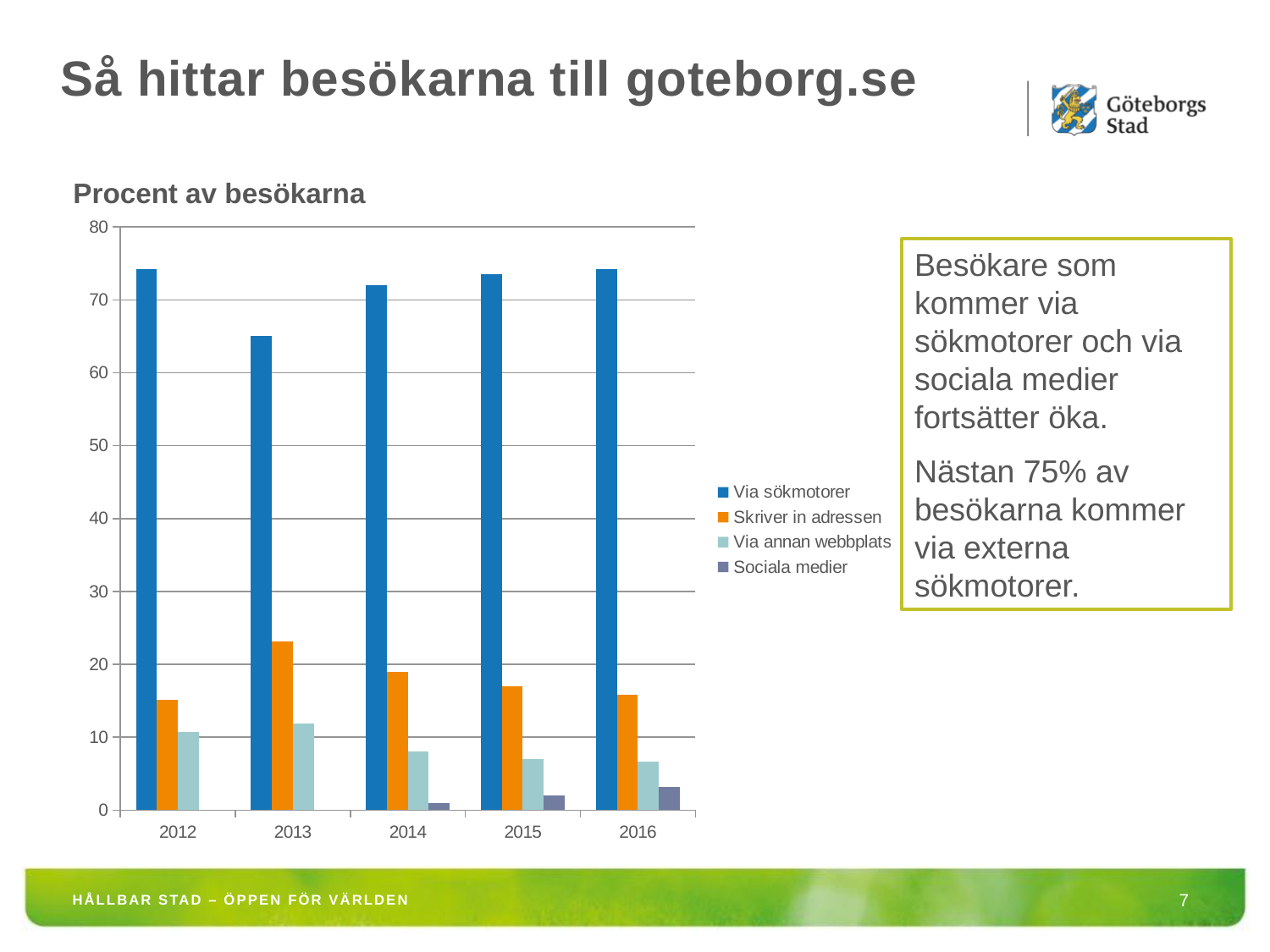
How many series does the legend list? 4 In which year is the value for Via sökmotorer lowest? 2013 Is the value for Via sökmotorer in 2013 greater or less than 60? greater How many years are shown on the x axis? 5 Do the values for Sociala medier rise or fall from 2014 to 2016? rise Is the value for Via annan webbplats in 2016 greater or less than 10? less What is the title of the chart? Procent av besökarna Is the value for Skriver in adressen in 2013 greater or less than 20? greater Which is larger in 2016, Skriver in adressen or Sociala medier? Skriver in adressen What kind of chart is shown on the slide? Bar chart In which year is the value for Via annan webbplats highest? 2013 In which year is the value for Skriver in adressen highest? 2013